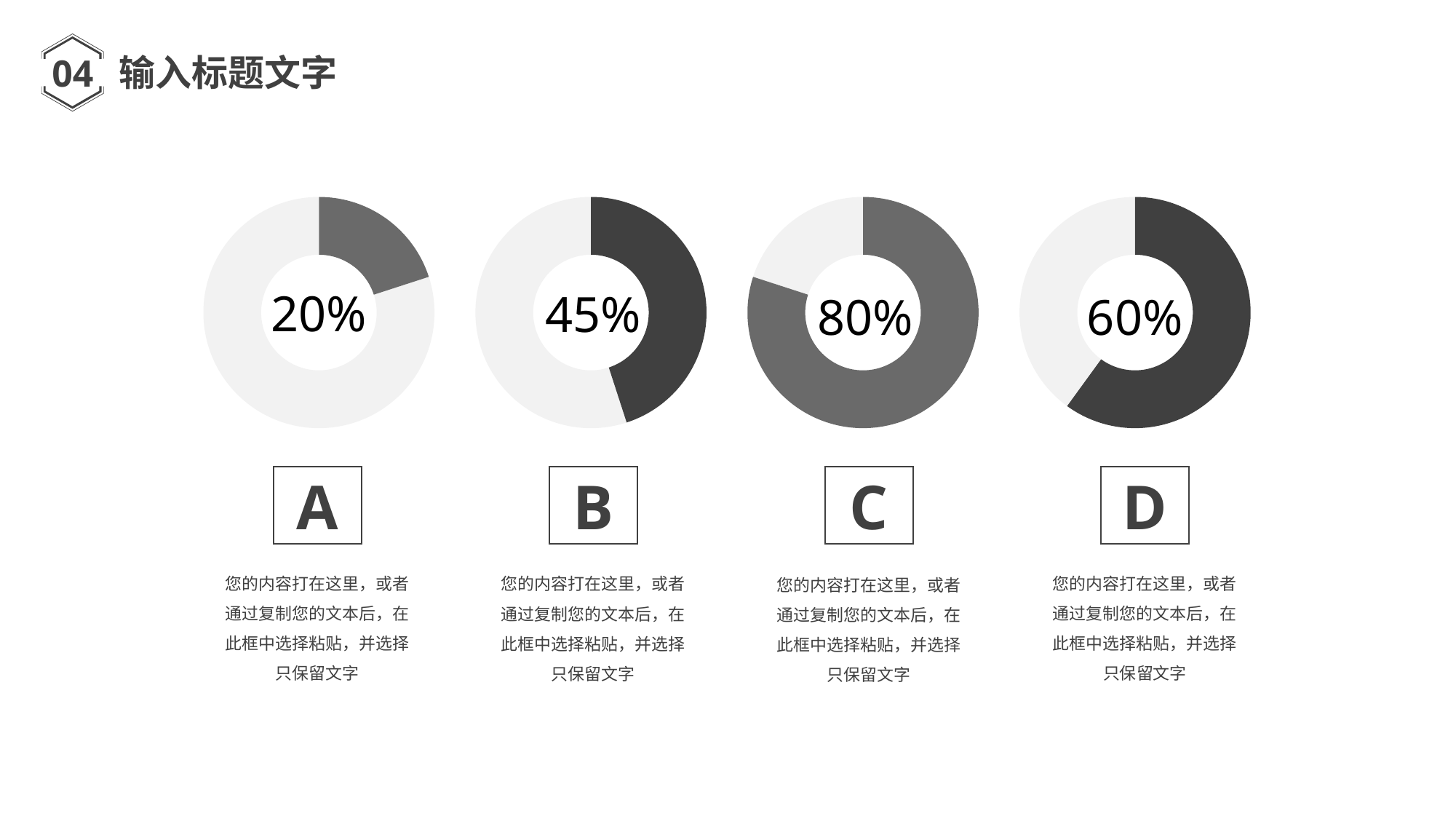
Which of the four donut charts (A, B, C or D) shows the highest percentage? C What percentage is shown in the donut chart labelled C? 80% How many donut charts are on the slide? 4 What kind of chart is used for A, B, C and D on the slide? Donut (pie) chart What is the difference between the percentage in chart D and the percentage in chart B? 15% Reading the charts from left to right (A to D), do the percentages rise steadily, fall steadily, or neither? Neither What percentage is shown in the donut chart labelled D? 60% Which shows a larger percentage, chart B or chart D? D What percentage is shown in the donut chart labelled A? 20% What percentage is shown in the donut chart labelled B? 45% Which of the four donut charts (A, B, C or D) shows the lowest percentage? A What is the difference between the percentage in chart C and the percentage in chart A? 60%